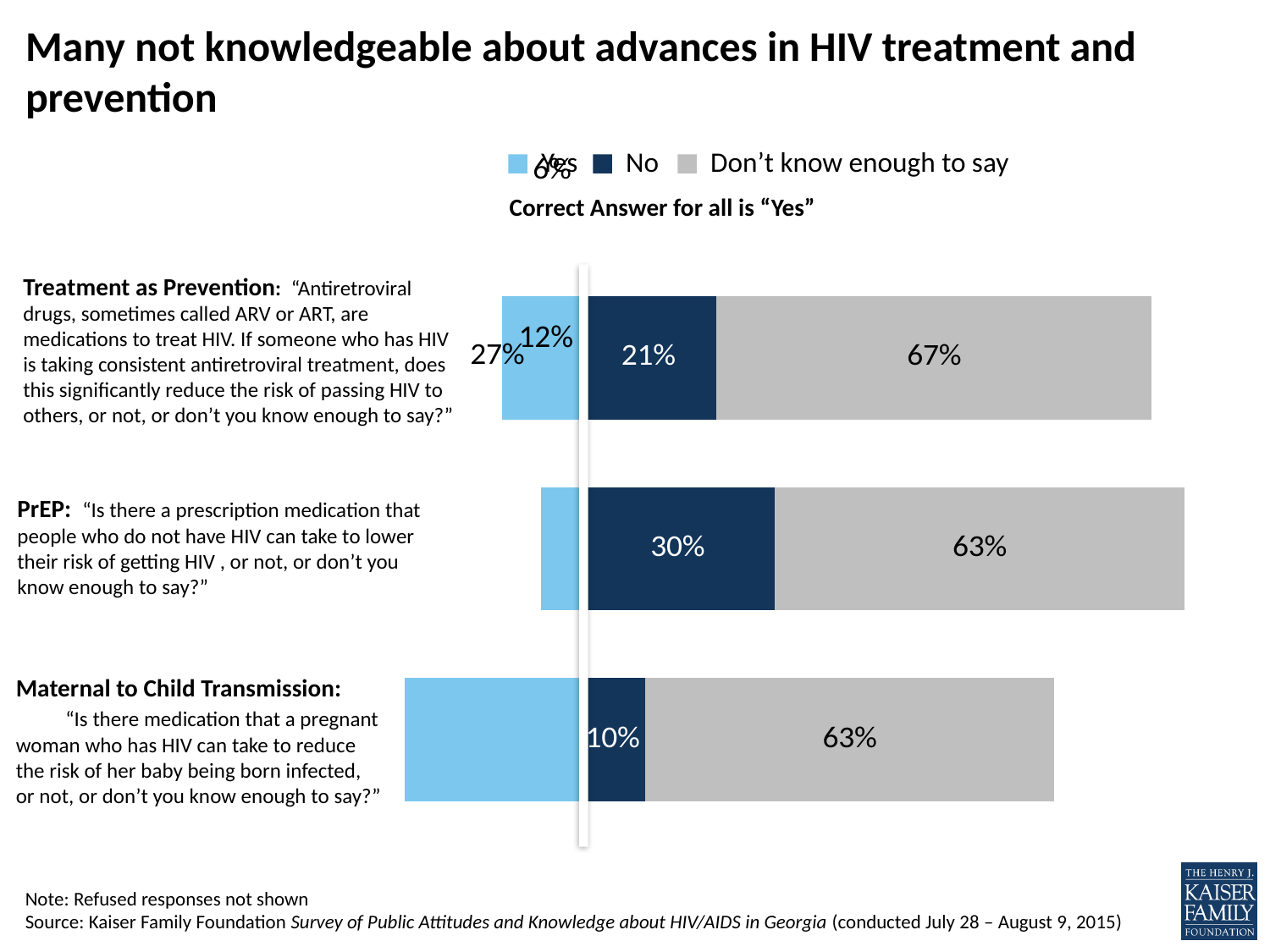
What percentage answered "Don't know enough to say" for Maternal to Child Transmission? 63% How many percentage points higher is the "No" share for PrEP than for Maternal to Child Transmission? 20 percentage points What type of chart is shown on the slide? Stacked bar chart What percentage answered "No" for PrEP? 30% Which has a larger "No" share: Treatment as Prevention or PrEP? PrEP Which question has the lowest share of "No" responses? Maternal to Child Transmission How many survey questions (categories) are shown in the chart? 3 According to the note above the chart, what is the correct answer for all three questions? Yes Which question has the highest share of "Don't know enough to say" responses? Treatment as Prevention What percentage of respondents answered "No" for Treatment as Prevention? 21% What percentage answered "Don't know enough to say" for Treatment as Prevention? 67% How many response series does the legend list? 3